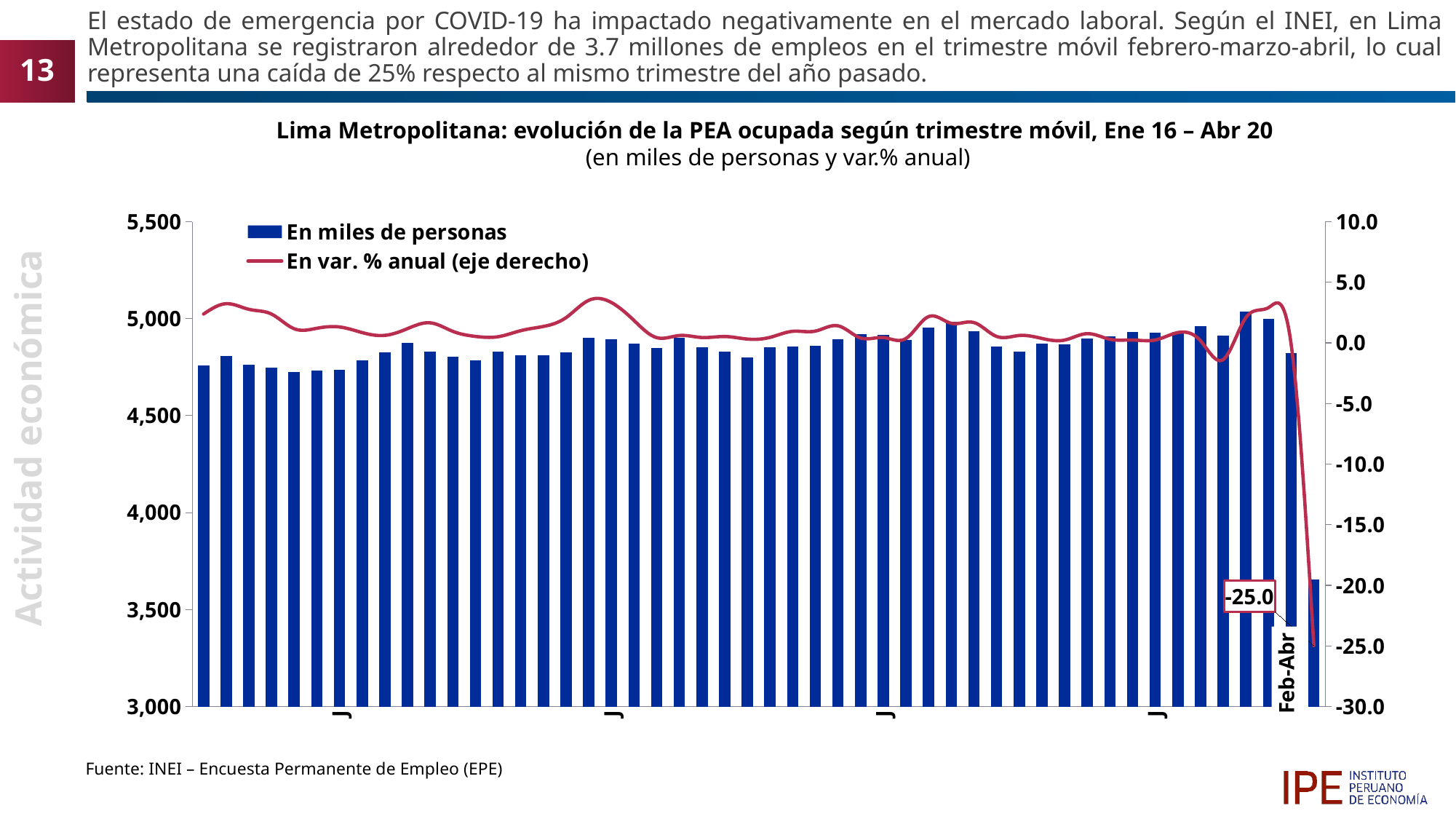
What is the title of the chart? Lima Metropolitana: evolución de la PEA ocupada según trimestre móvil, Ene 16 – Abr 20 Is the annual % variation for Feb-Abr greater or less than -20.0? less Is the number of employed persons (bar) for Feb-Abr greater or less than 4,000? less Which period has the lowest bar for employed persons? Feb-Abr What kind of chart is shown on the slide? A combination bar and line chart Is the leftmost bar (first period) greater or less than 4,500 thousand persons? greater What are the two series named in the legend? En miles de personas; En var. % anual (eje derecho) How many series does the legend list? 2 Does the annual % variation line rise or fall at the right end of the chart? fall Which is larger: the bar for Feb-Abr or the bar immediately before it? The bar immediately before it What is the annual % variation shown for the Feb-Abr period? -25.0